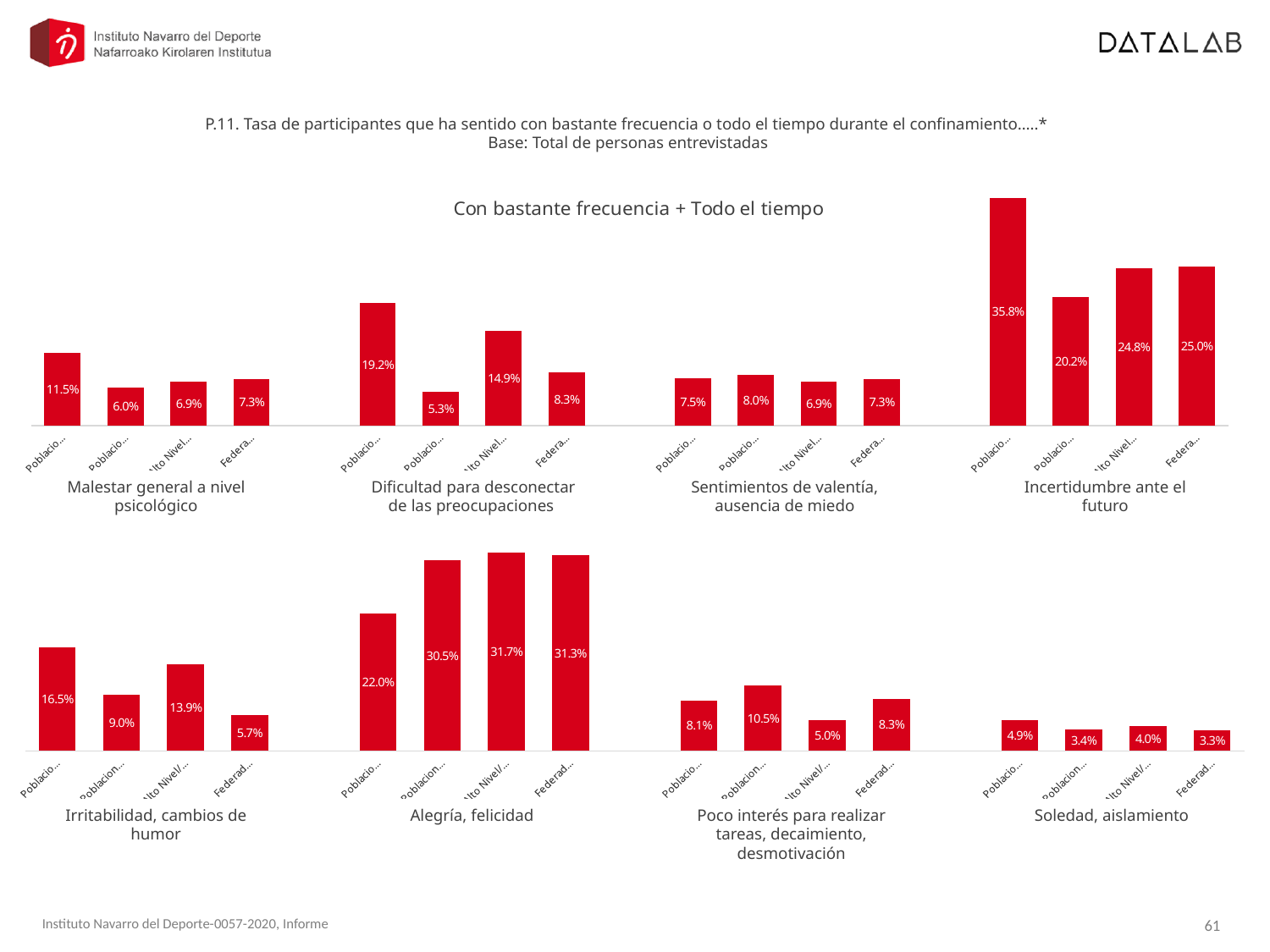
In the 'Irritabilidad, cambios de humor' chart, what is the difference between the first bar (16.5%) and the fourth bar (5.7%)? 10.8 percentage points What type of chart is used for 'Alegría, felicidad'? Bar chart In the 'Soledad, aislamiento' chart, what is the lowest value shown? 3.3% In the 'Incertidumbre ante el futuro' chart, what is the value of the first bar? 35.8% In the 'Dificultad para desconectar de las preocupaciones' chart, which bar has the highest value? The first bar (19.2%) In the 'Poco interés para realizar tareas, decaimiento, desmotivación' chart, which is larger: the second bar or the fourth bar? The second bar (10.5%) How many separate bar charts are shown on the slide? 8 In the 'Alegría, felicidad' chart, what is the value of the third bar? 31.7% How many bars does the 'Sentimientos de valentía, ausencia de miedo' chart contain? 4 In the 'Malestar general a nivel psicológico' chart, what is the value of the second bar? 6.0% In the 'Incertidumbre ante el futuro' chart, what is the difference between the first bar (35.8%) and the second bar (20.2%)? 15.6 percentage points What is the common title shown above the charts on the slide? Con bastante frecuencia + Todo el tiempo